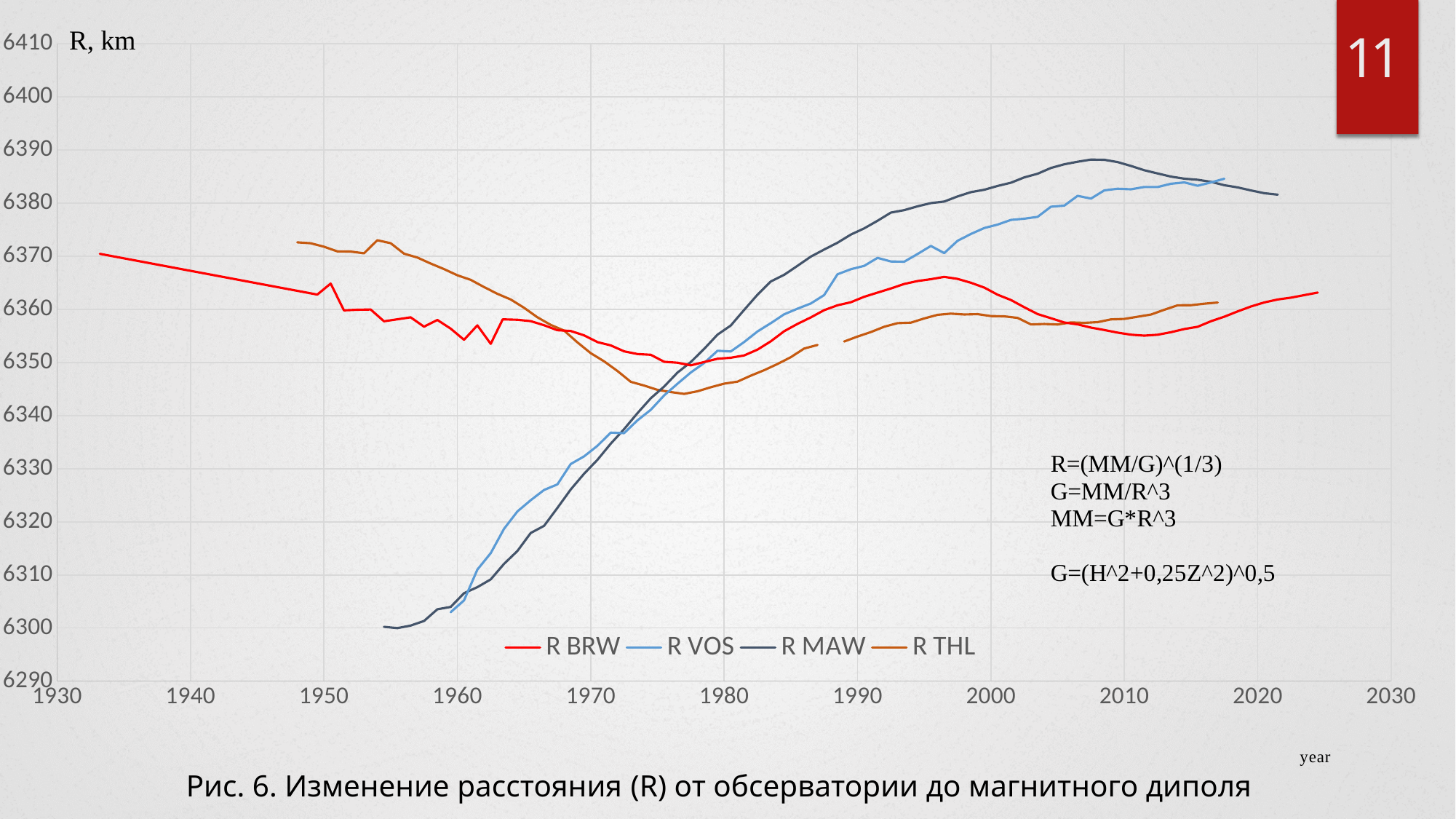
Is the lowest value of R THL, around 1977, greater or less than 6350? less What is the label on the vertical axis? R, km Does R MAW rise or fall between 1955 and 2008? rise What kind of chart is shown on the slide? line chart Is the value of R MAW at its starting point around 1955 greater or less than 6310? less Around 2010, which series has the larger value, R MAW or R BRW? R MAW How many series does the legend list? 4 Is the value of R VOS in 1960 greater or less than 6310? less Which series reaches the highest value anywhere on the chart? R MAW In 1960, which series has the larger value, R BRW or R VOS? R BRW What are the four series named in the legend? R BRW, R VOS, R MAW, R THL